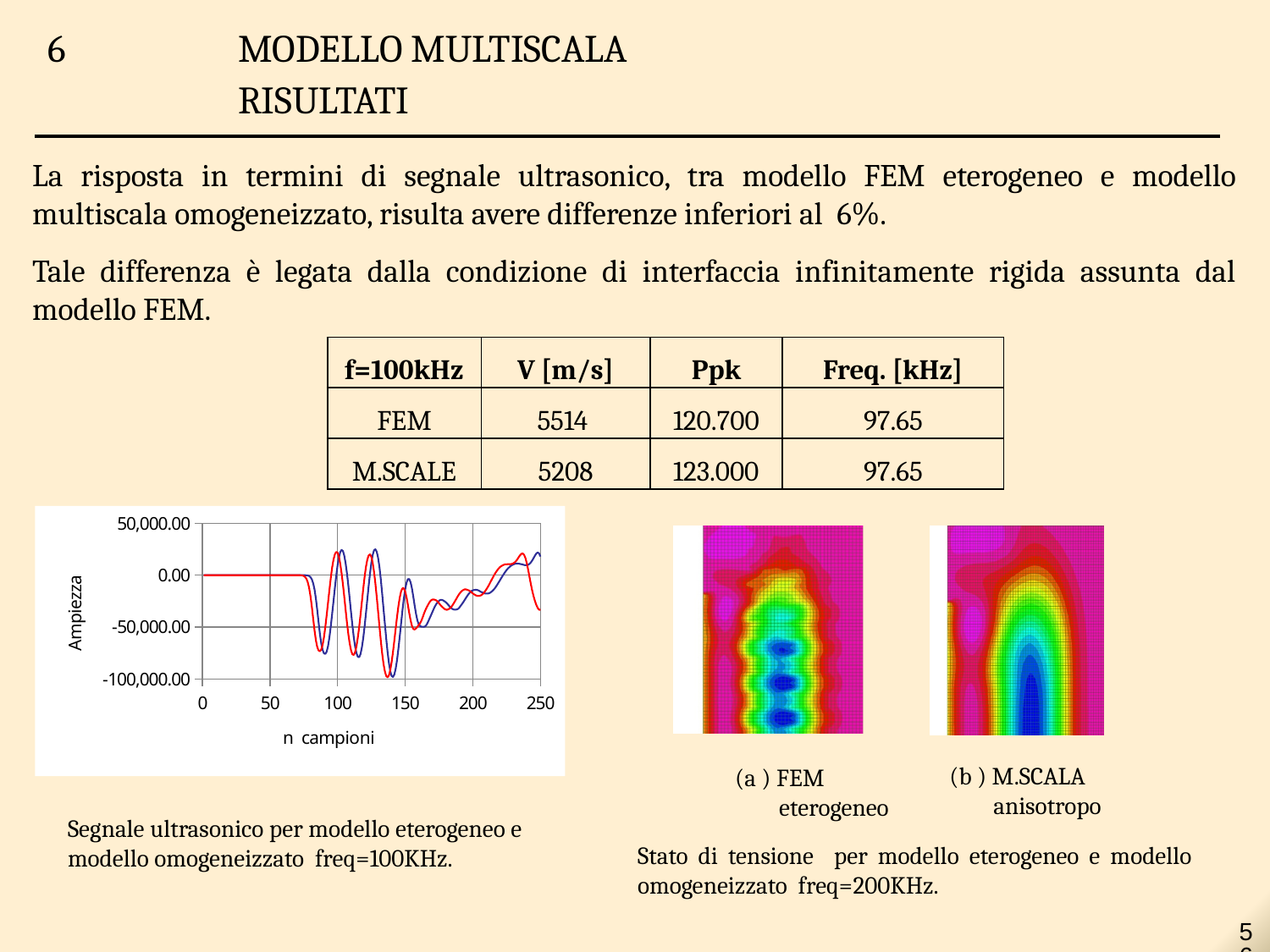
In the line chart at the bottom left, is the highest value reached by the blue line greater or less than 50,000.00? less What kind of chart is shown at the bottom left of the slide? line chart In the line chart at the bottom left, what is the label of the x axis? n campioni How many lines (data series) are plotted in the line chart at the bottom left? 2 In the line chart at the bottom left, is the lowest value reached by the blue line greater or less than -50,000.00? less In the line chart at the bottom left, is the lowest value reached by the red line greater or less than -50,000.00? less In the line chart at the bottom left, what value do both lines hold over the first samples (from 0 to about 70 campioni)? 0.00 In the line chart at the bottom left, what is the label of the y axis? Ampiezza